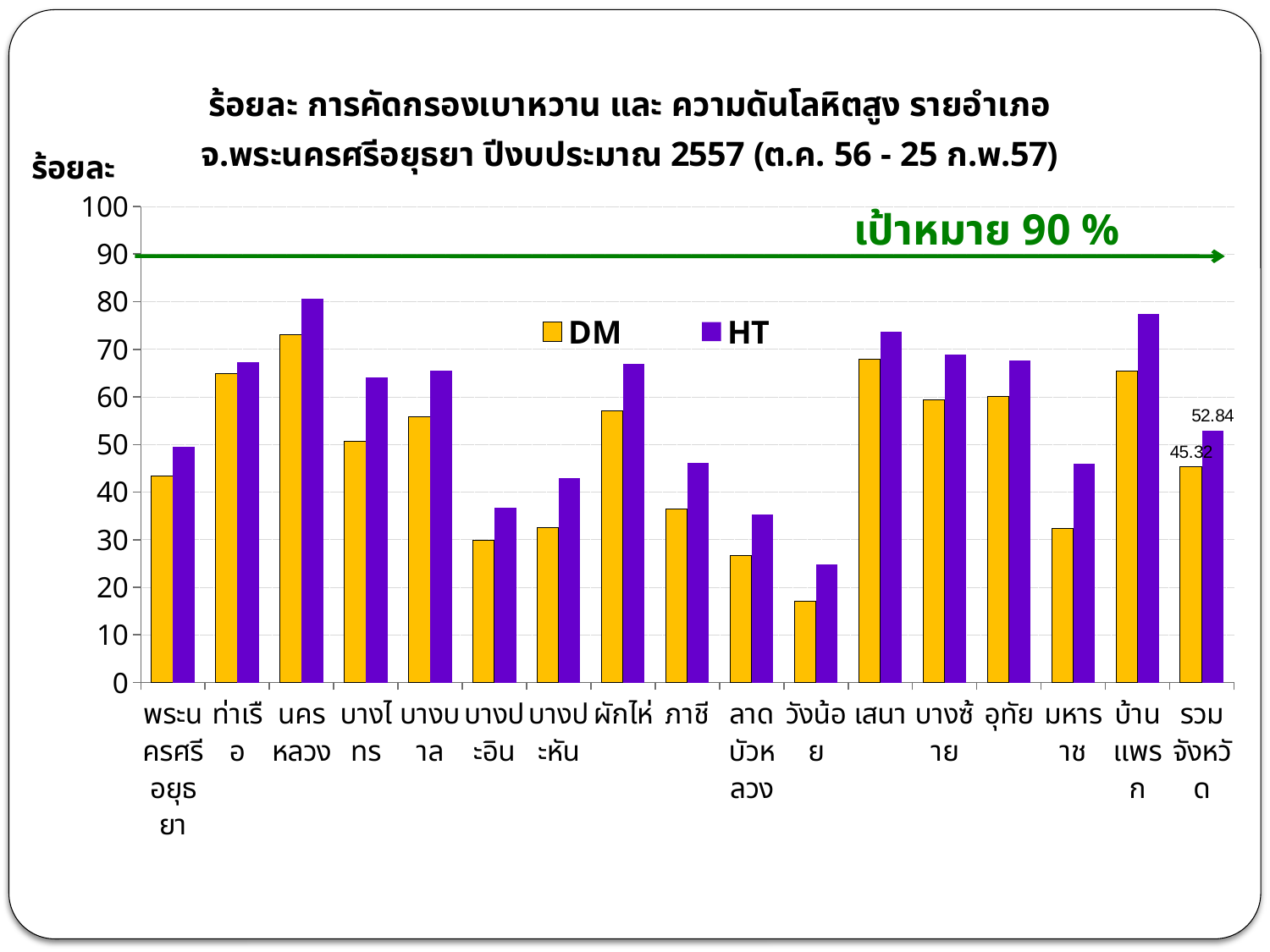
Is the DM value for วังน้อย greater or less than 20? less Is the HT value for บ้านแพรก greater or less than 70? greater How many series does the legend list? 2 What is the difference between the HT and DM values for รวมจังหวัด? 7.52 What target percentage is marked by the green line on the chart? 90 % Which category has the lowest HT value? วังน้อย What is the HT value for รวมจังหวัด? 52.84 What type of chart is shown on the slide? bar chart For รวมจังหวัด, which is larger, the DM value or the HT value? HT Which category has the highest DM value? นครหลวง How many categories are shown along the x axis? 17 What is the DM value for รวมจังหวัด? 45.32